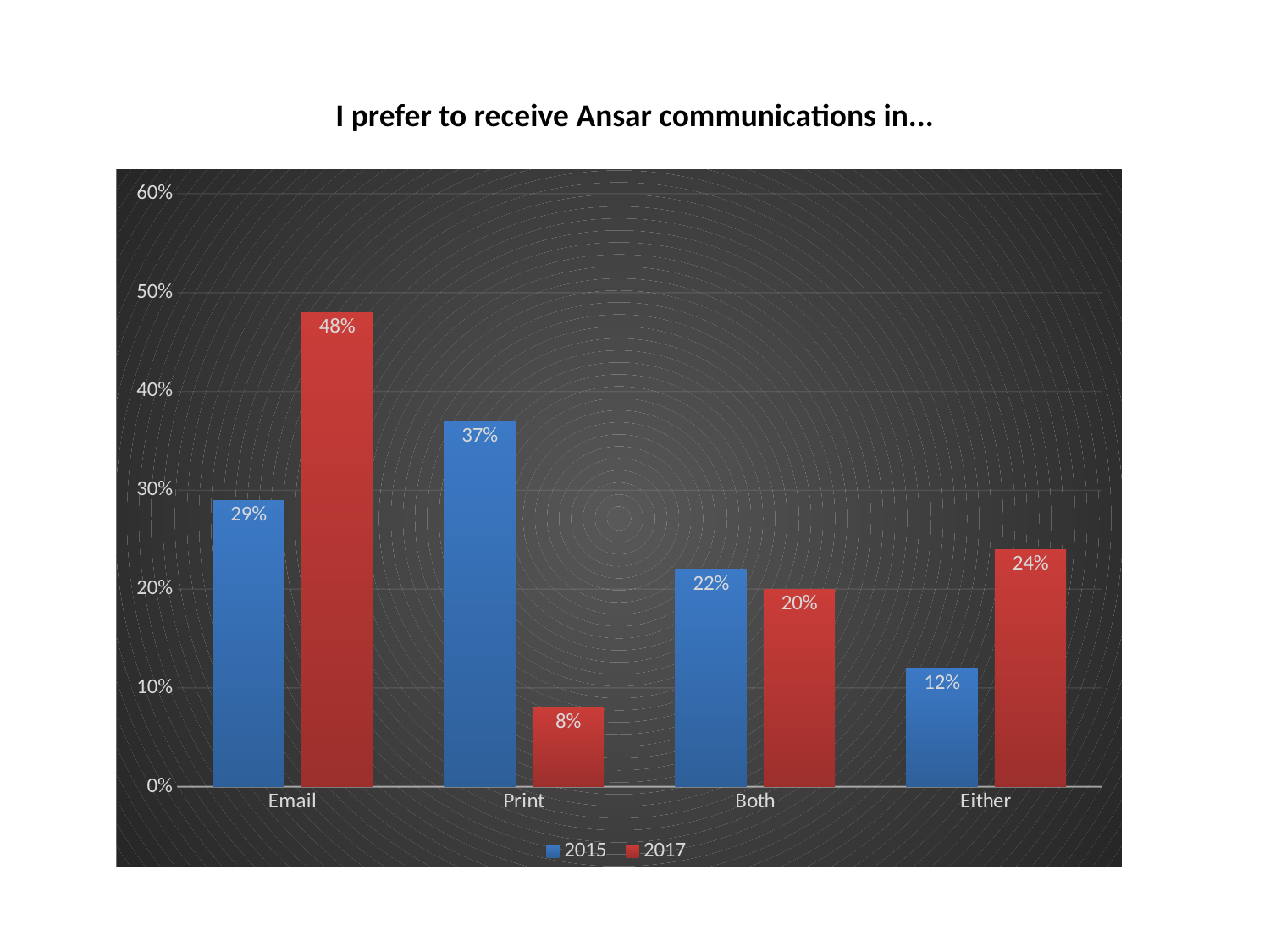
What kind of chart is shown? bar chart What is the 2015 value for Either? 12% What is the title of the chart? I prefer to receive Ansar communications in... Which category has the lowest 2017 value? Print How many series does the legend list? 2 Which category has the highest 2017 value? Email Which is larger for Both: the 2015 value or the 2017 value? 2015 How many categories are shown on the x axis? 4 What is the 2015 value for Print? 37% What is the difference between the 2015 and 2017 values for Print? 29% What is the 2017 value for Email? 48% Is the 2015 value for Email greater or less than 20%? greater